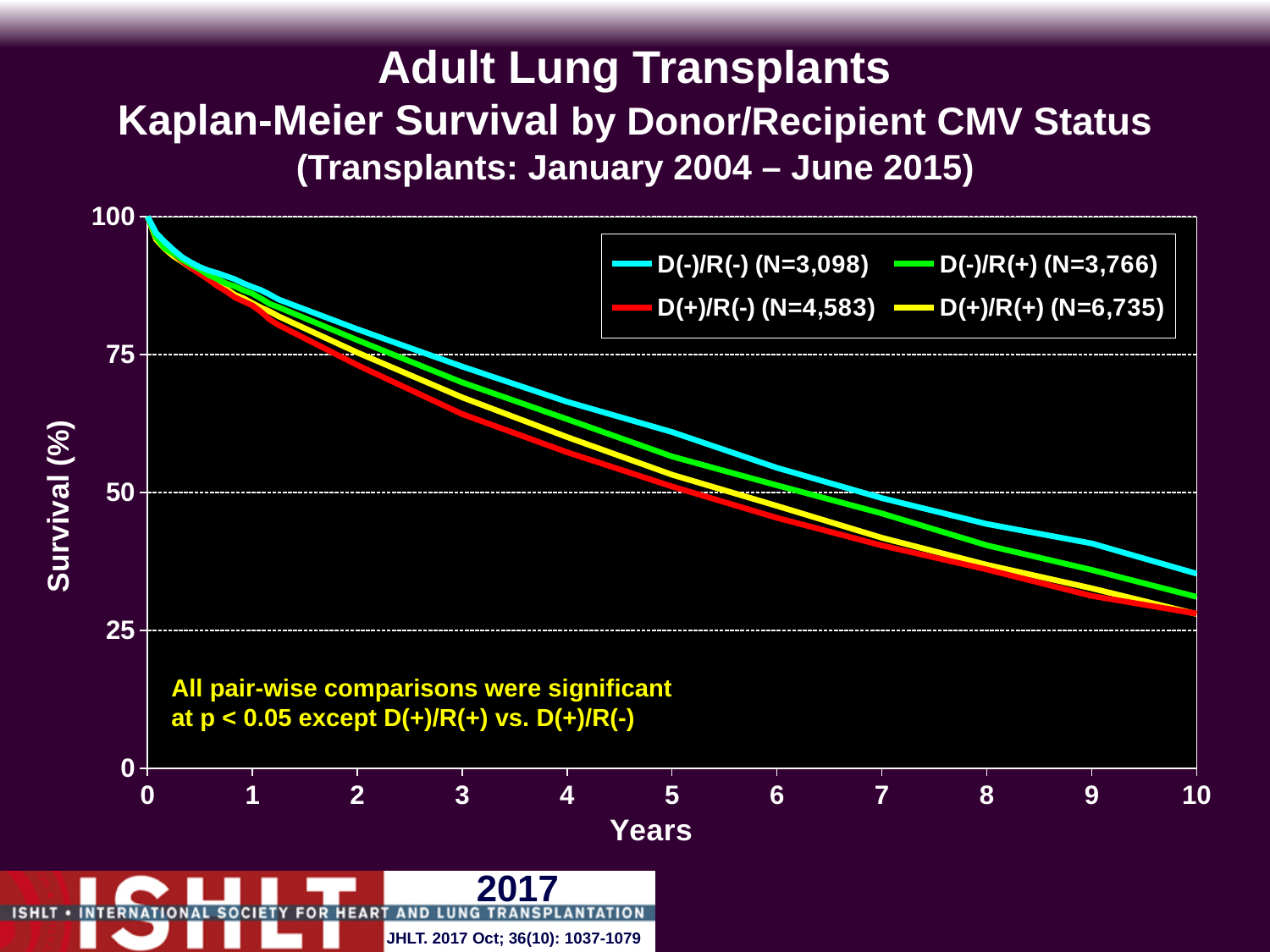
What is the N for the D(+)/R(+) group shown in the legend? 6,735 Which CMV status group has the smallest N in the legend? D(-)/R(-) What is the difference between the N for D(+)/R(+) and the N for D(-)/R(-)? 3,637 What kind of chart is shown on the slide? line chart Is the survival for D(+)/R(+) at 7 years greater or less than 50? less How many series does the legend list? 4 Is the survival for D(+)/R(-) at 3 years greater or less than 50? greater Which CMV status group has the largest N in the legend? D(+)/R(+) Do the survival curves rise or fall as years increase? fall At 10 years, which group has higher survival, D(-)/R(-) or D(+)/R(-)? D(-)/R(-) What is the N for the D(-)/R(-) group shown in the legend? 3,098 Is the survival for D(-)/R(-) at 10 years greater or less than 50? less